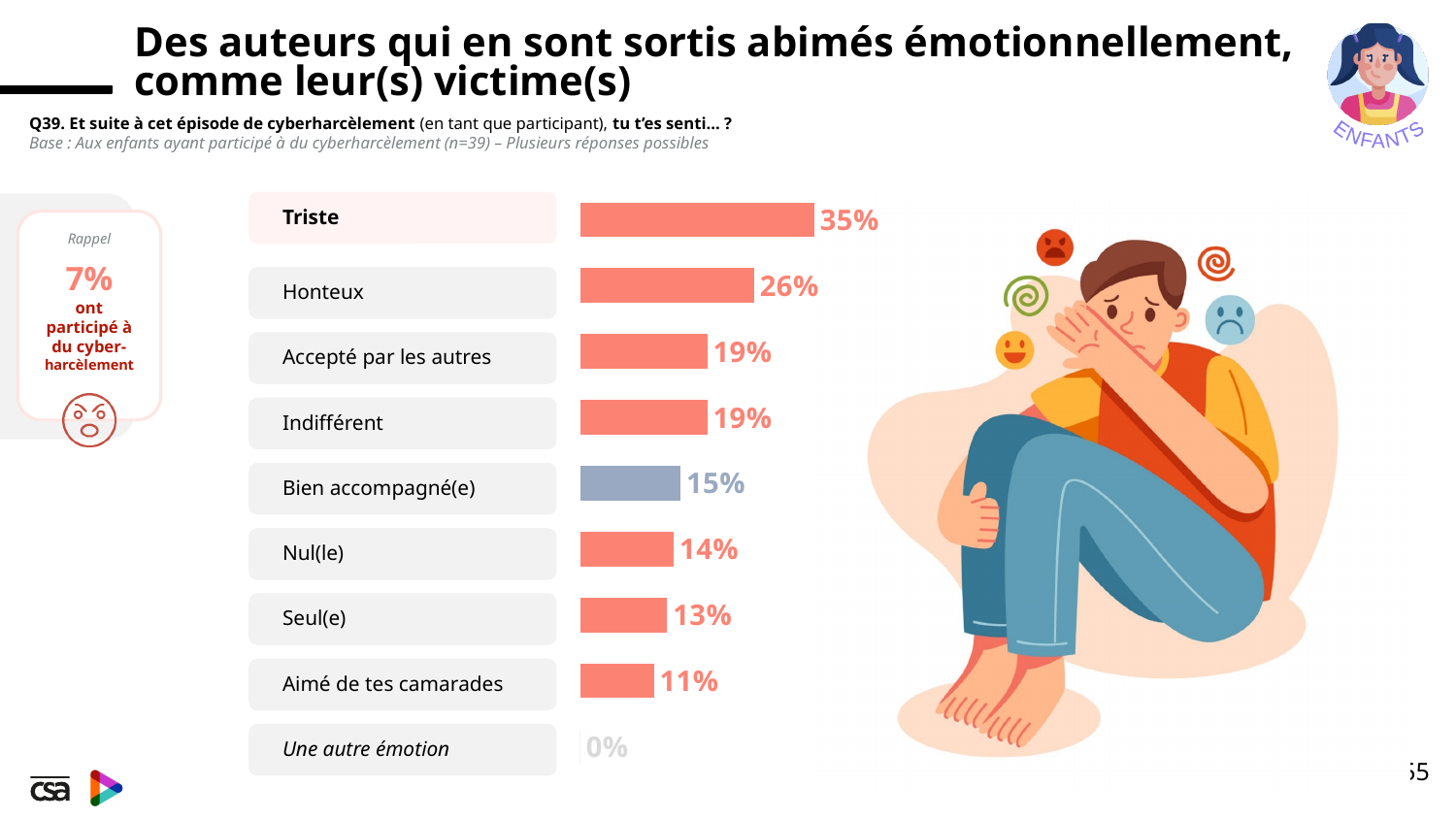
What kind of chart is shown on the slide? Bar chart Which is larger, the value for 'Nul(le)' or the value for 'Seul(e)'? Nul(le) What is the difference between the values for 'Triste' and 'Honteux'? 9% Which bar in the chart is coloured differently (blue-grey) from the others? Bien accompagné(e) Which two categories share the same value of 19%? Accepté par les autres and Indifférent What percentage is shown for 'Bien accompagné(e)'? 15% How many categories are shown in the chart? 9 What is the value for 'Aimé de tes camarades'? 11% What is the value shown for 'Honteux'? 26% Which category has the lowest value in the chart? Une autre émotion Which category has the highest value in the chart? Triste What percentage of respondents said they felt 'Triste'? 35%